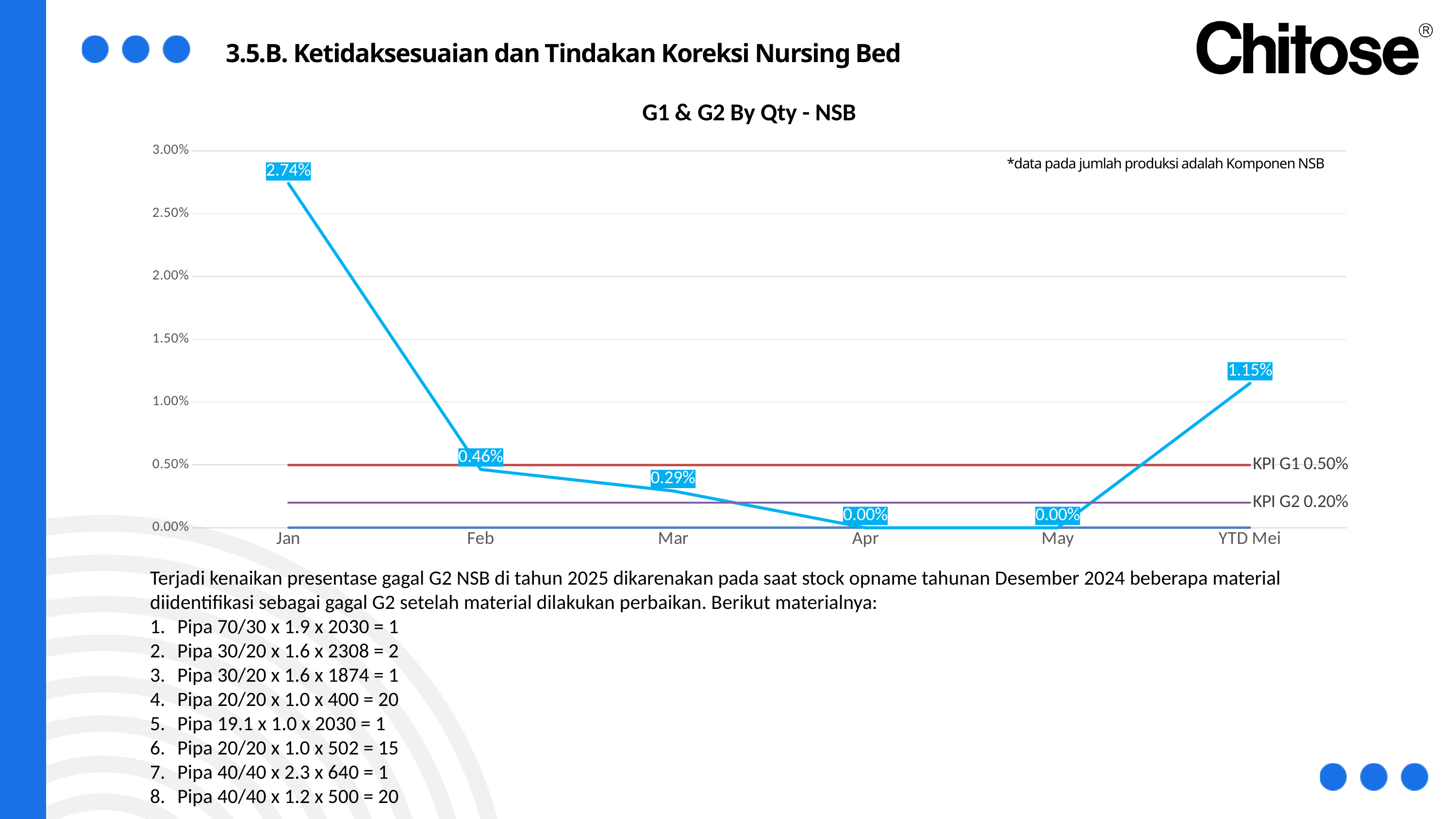
What is the title of the chart? G1 & G2 By Qty - NSB What is the value for Mar? 0.29% What is the value for Jan? 2.74% What value is shown for the KPI G1 reference line? 0.50% What is the difference between the values for Jan and Feb? 2.28% What type of chart is shown on the slide? line chart What is the value for YTD Mei? 1.15% Do the values rise or fall from Jan to Apr? fall Which is larger, the value for Feb or the value for Mar? Feb How many categories are shown on the x axis? 6 Which month has the highest value? Jan What is the value for Feb? 0.46%